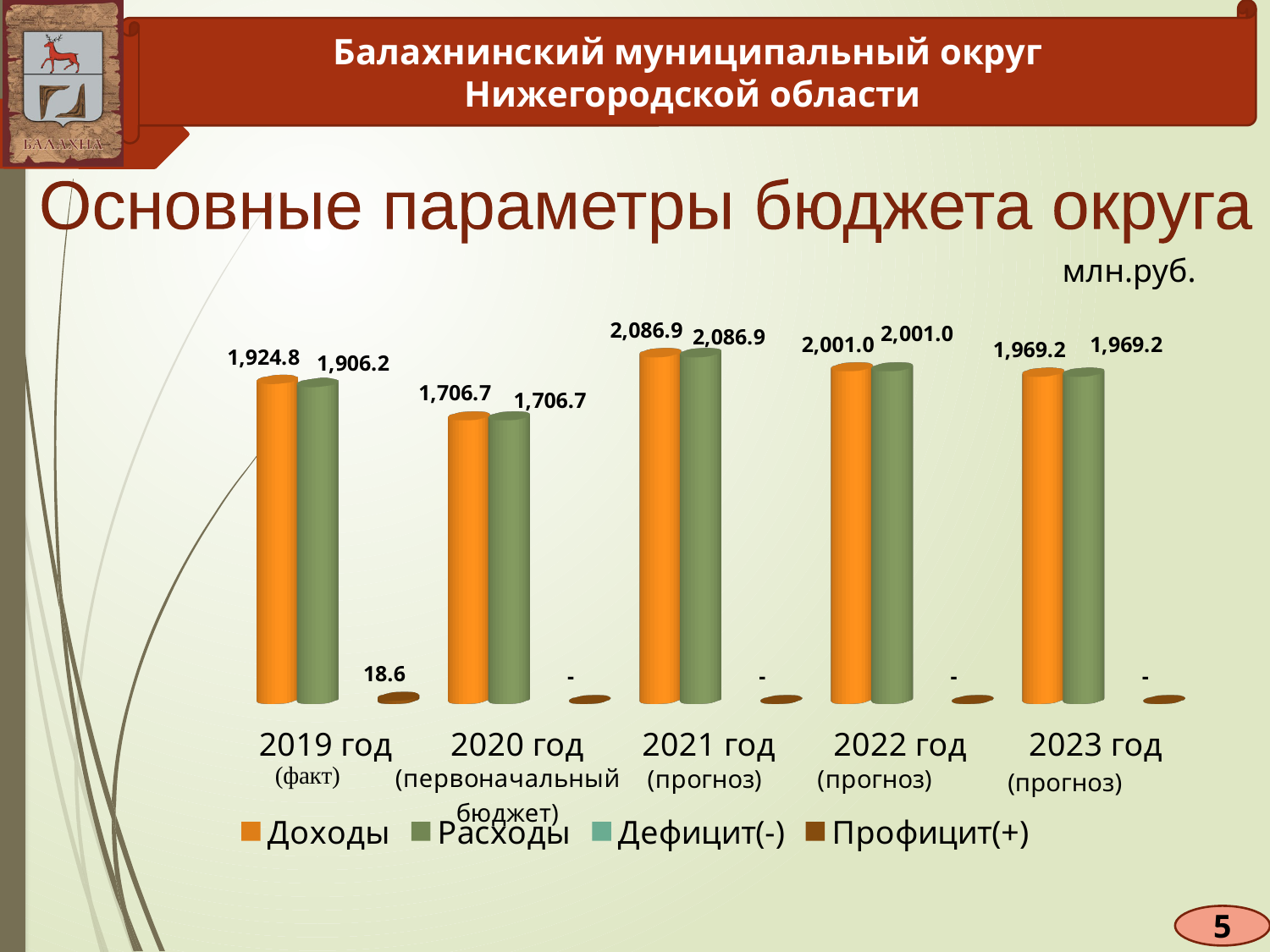
What is the value of Профицит(+) for 2019 год? 18.6 How many series does the legend list? 4 What is the value of Расходы for 2019 год? 1,906.2 In which year is Доходы the highest? 2021 год What is the difference between Доходы in 2021 год and Доходы in 2020 год? 380.2 Which is larger: Доходы in 2022 год or Доходы in 2023 год? 2022 год What is the value of Доходы for 2021 год? 2,086.9 What is the difference between Доходы and Расходы in 2019 год? 18.6 What is the value of Доходы for 2019 год? 1,924.8 In which year is Доходы the lowest? 2020 год What is the value of Расходы for 2023 год? 1,969.2 How many year categories are shown on the x axis? 5